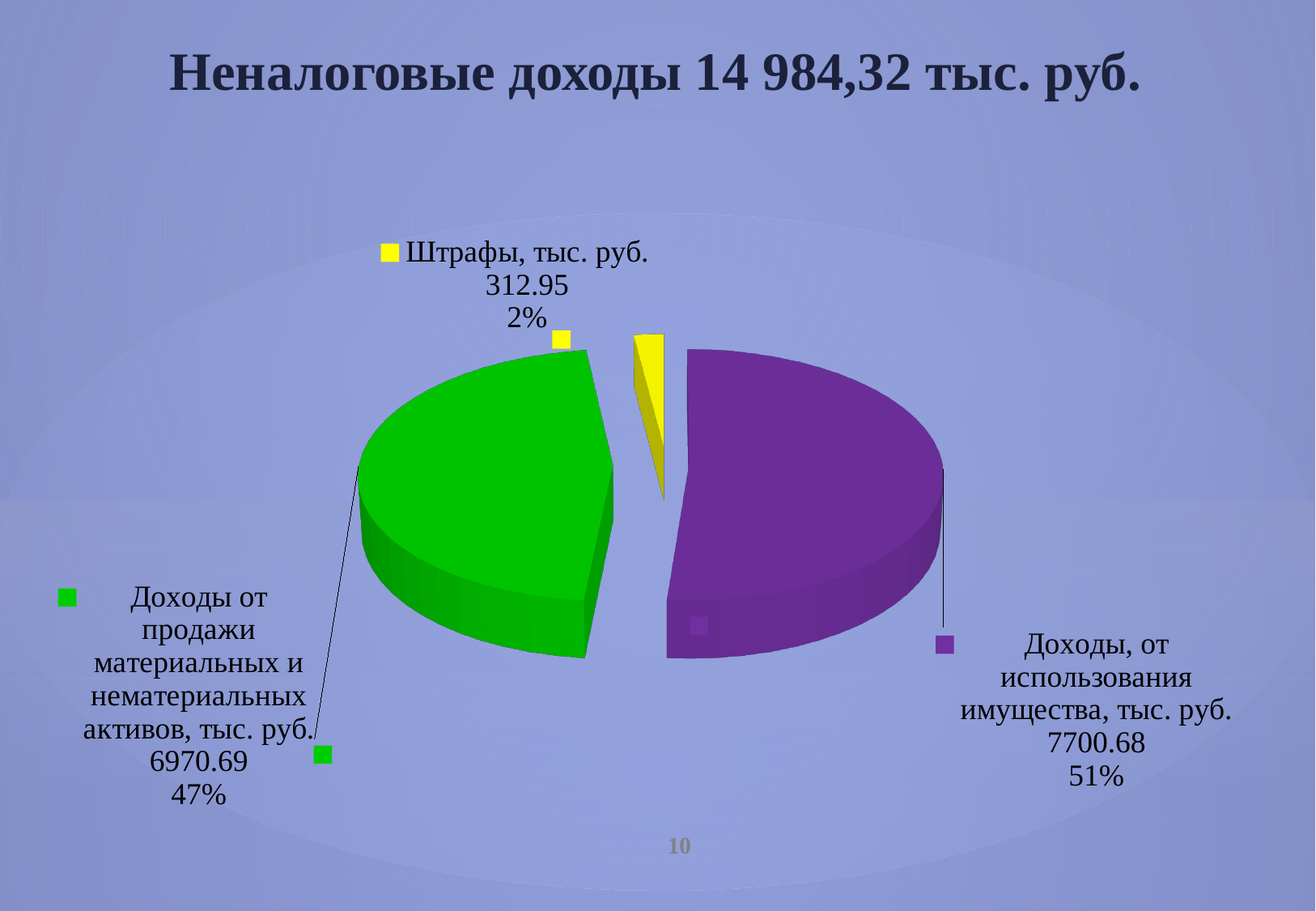
What share of the pie does Доходы от продажи материальных и нематериальных активов account for? 47% What is the difference between the value for Доходы, от использования имущества and the value for Доходы от продажи материальных и нематериальных активов? 729.99 What share of the pie does Доходы, от использования имущества account for? 51% Which category has the largest slice of the pie? Доходы, от использования имущества, тыс. руб. What kind of chart is shown on the slide? Pie chart What is the title of the chart on the slide? Неналоговые доходы 14 984,32 тыс. руб. What is the value shown for Доходы от продажи материальных и нематериальных активов, тыс. руб.? 6970.69 How many slices does the pie chart have? 3 What is the value shown for Штрафы, тыс. руб.? 312.95 What share of the pie does Штрафы account for? 2% Which category has the smallest slice of the pie? Штрафы, тыс. руб. What is the value shown for Доходы, от использования имущества, тыс. руб.? 7700.68